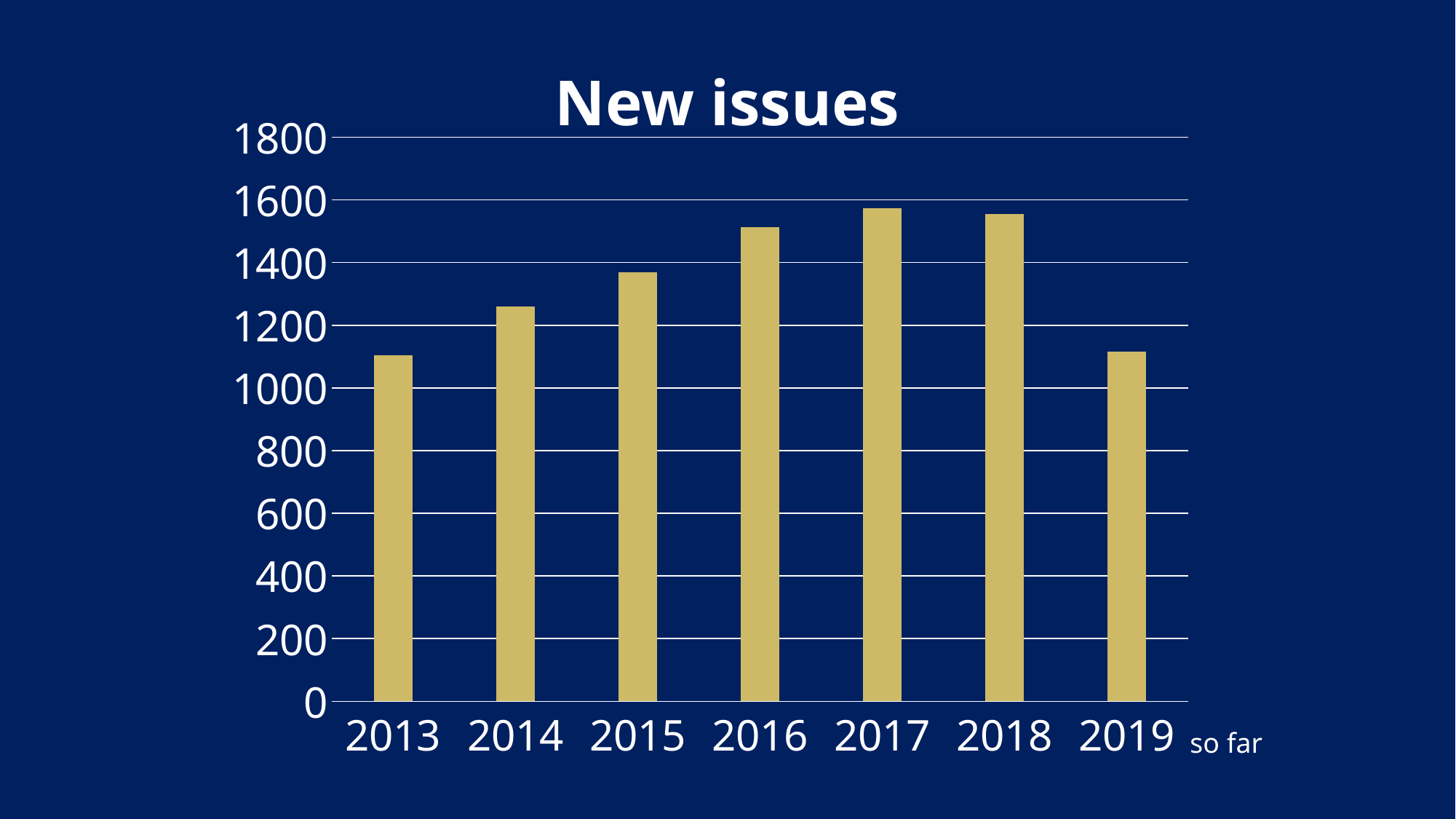
Which year has the larger value, 2014 or 2016? 2016 Which year has the larger value, 2015 or 2019? 2015 Do the values rise or fall from 2013 to 2017? rise What is the title of the chart? New issues What kind of chart is shown on the slide? bar chart Is the value for 2019 greater or less than 1200? less Is the value for 2013 greater or less than 1200? less Is the value for 2016 greater or less than 1400? greater How many years are shown on the x axis of the chart? 7